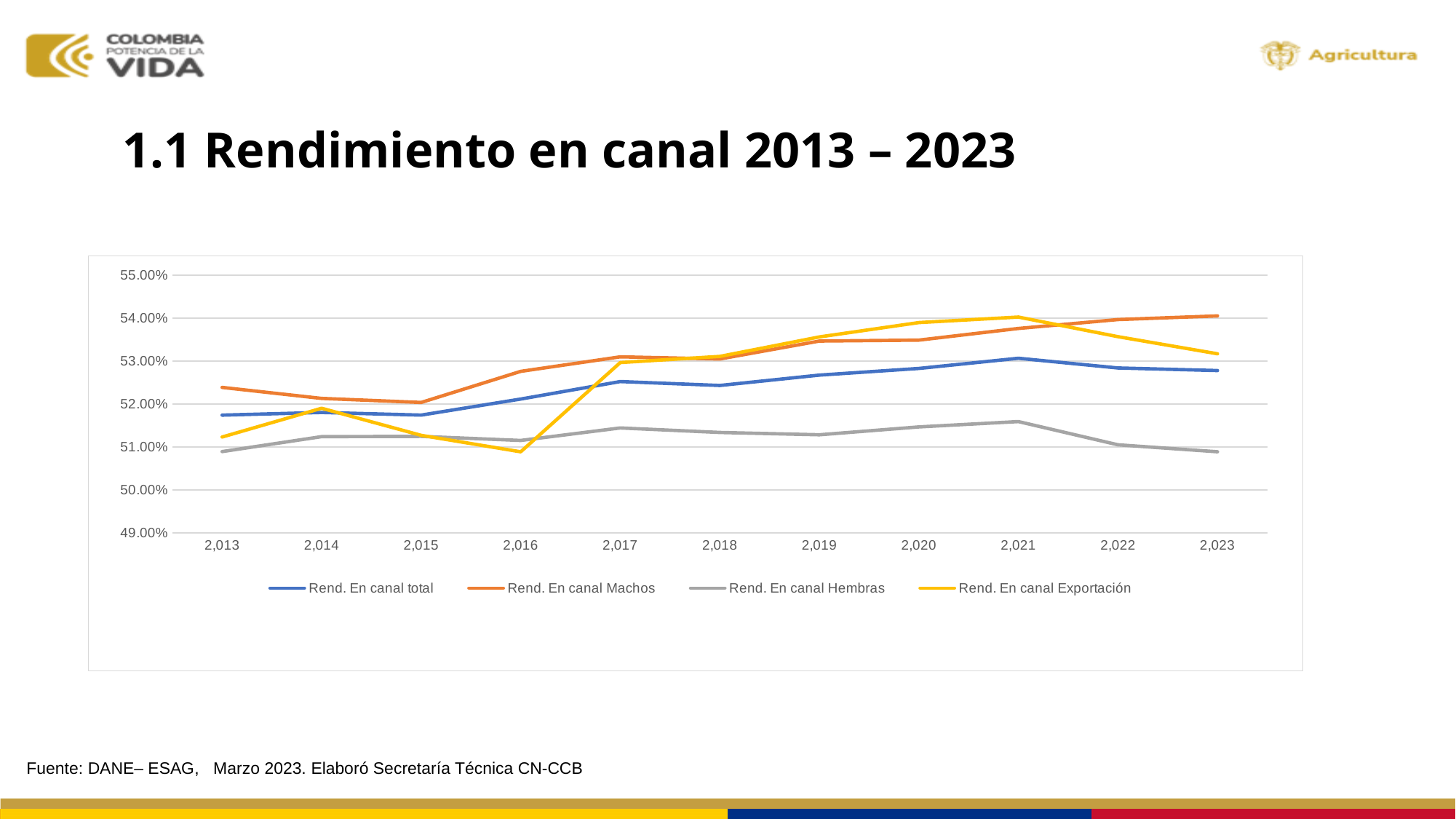
In 2,016, which is larger: Rend. En canal total or Rend. En canal Exportación? Rend. En canal total How many years are plotted along the x axis of the chart? 11 Is the value for Rend. En canal Machos in 2,023 greater or less than 53.00%? greater What is the title of the slide containing the chart? 1.1 Rendimiento en canal 2013 – 2023 What kind of chart is shown on the slide? Line chart Is the value for Rend. En canal Hembras in 2,021 greater or less than 52.00%? less In which year does Rend. En canal Exportación reach its lowest value? 2,016 Which series is represented by the yellow line in the chart? Rend. En canal Exportación Is the value for Rend. En canal total in 2,013 greater or less than 52.00%? less In 2,023, which series has the lowest value? Rend. En canal Hembras How many series does the chart legend list? 4 Does Rend. En canal Machos generally rise or fall from 2,013 to 2,023? Rise